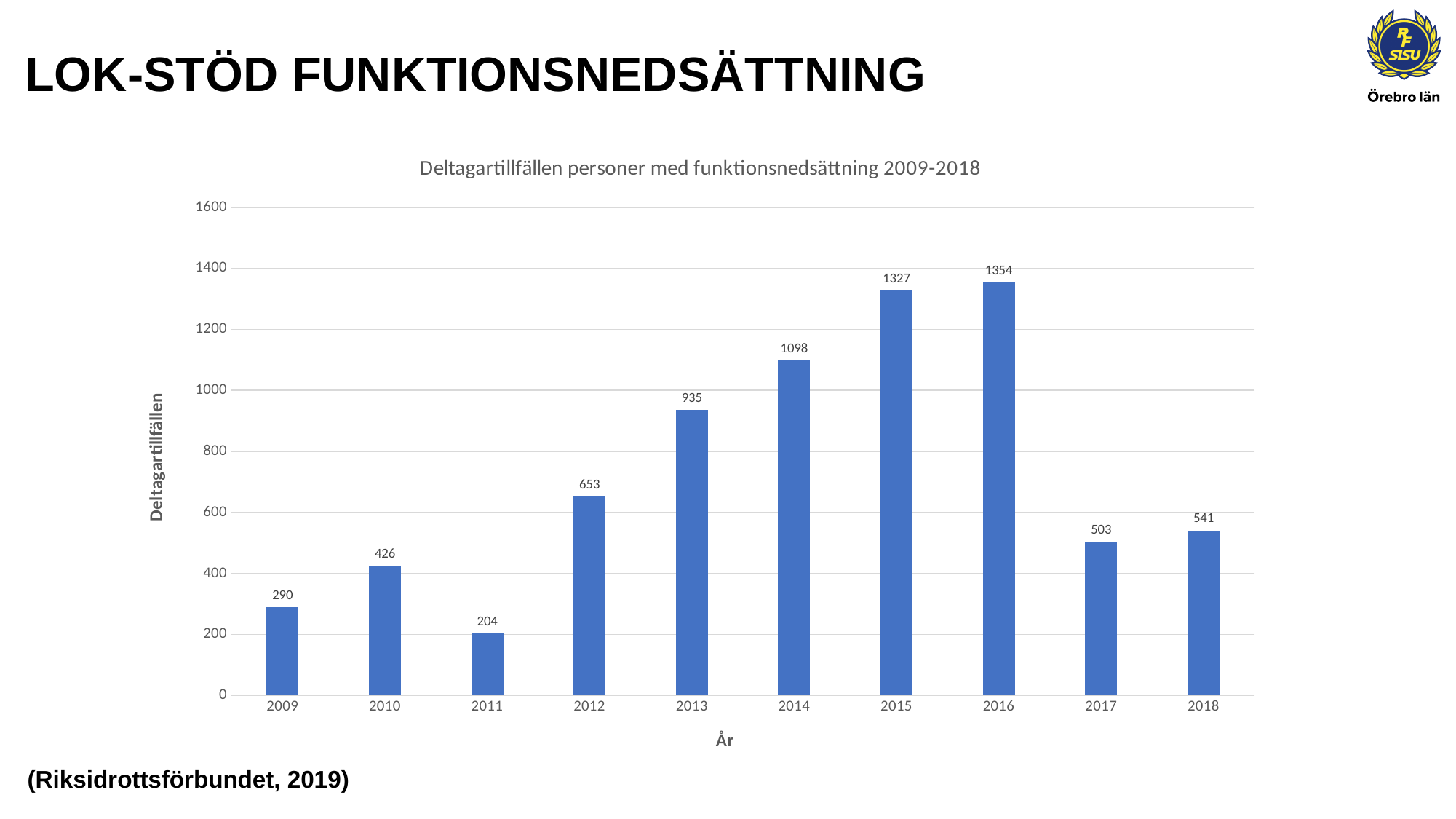
What is the value for 2011? 204 What is the value for 2018? 541 How many years are shown on the x axis? 10 Which year has the highest value? 2016 What is the value for 2014? 1098 What is the difference between the values for 2016 and 2015? 27 Is the value for 2013 greater or less than 1000? less What is the title of the chart? Deltagartillfällen personer med funktionsnedsättning 2009-2018 Which year has the lowest value? 2011 What is the difference between the values for 2013 and 2012? 282 Which is larger, the value for 2010 or the value for 2017? 2017 What kind of chart is shown on the slide? bar chart